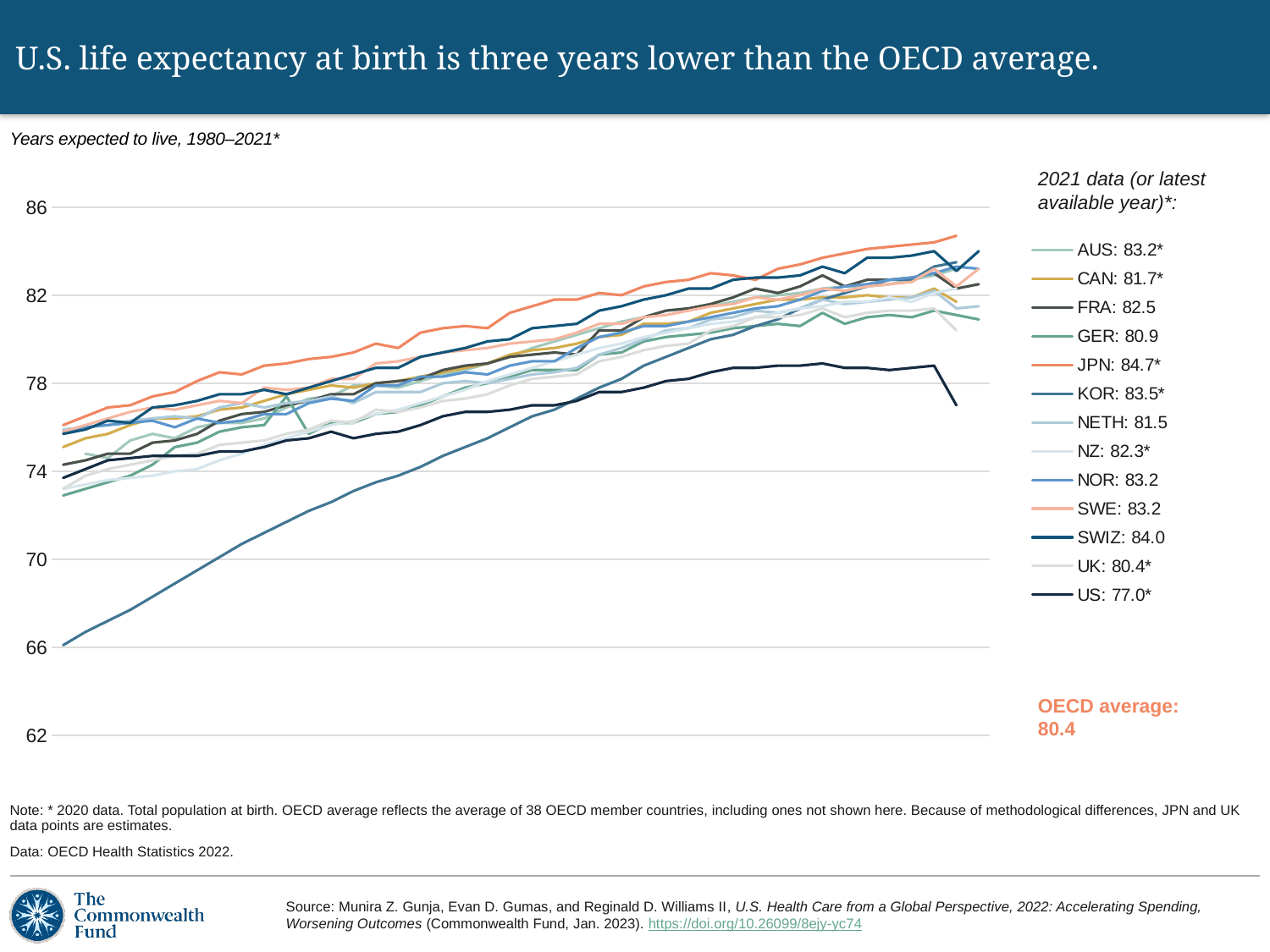
How many countries does the legend list? 13 Which country has the lowest 2021 (or latest) life expectancy in the legend? US Which country has the highest 2021 (or latest) life expectancy in the legend? JPN What is the OECD average life expectancy shown on the slide? 80.4 What is the 2021 (or latest available) life expectancy for the US? 77.0* What kind of chart is shown on the slide? line chart What is the 2021 life expectancy for Switzerland (SWIZ)? 84.0 What is the difference between Japan's (84.7) and the US's (77.0) latest life expectancy values? 7.7 What is the 2021 (or latest available) life expectancy for Japan (JPN)? 84.7* Is Korea's (KOR) life expectancy in 1980 greater or less than 70? less Does the US life expectancy line generally rise or fall from 1980 to 2019? rise Which has a higher latest life expectancy, Germany (GER) or France (FRA)? FRA